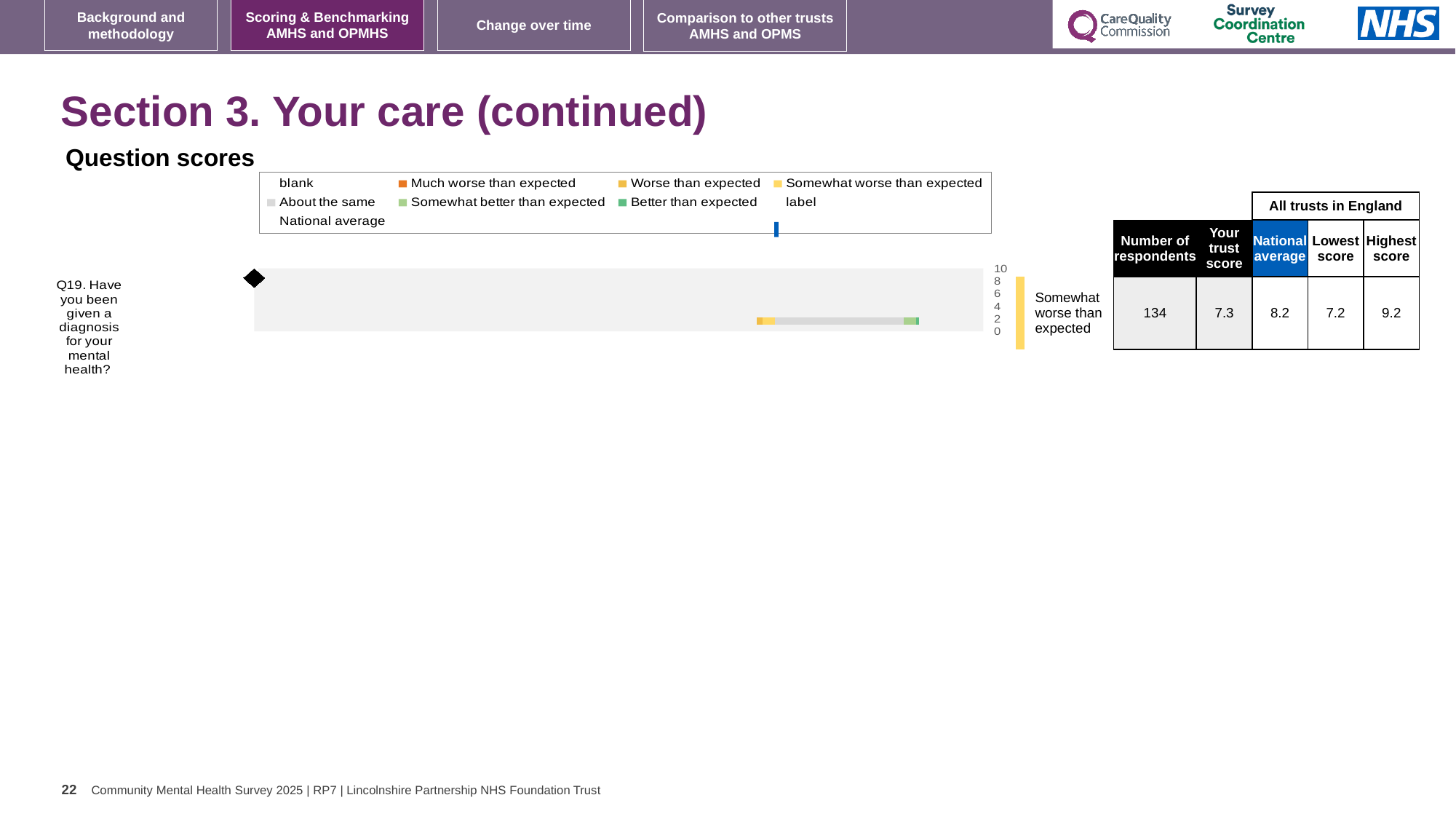
What kind of chart is used to show the question scores on this slide? bar chart What is the difference between the national average and the trust score for Q19? 0.9 Which is larger for Q19, the trust score or the national average? national average Which question is shown in the question scores chart? Q19. Have you been given a diagnosis for your mental health? What is the difference between the highest and lowest scores among all trusts in England for Q19? 2.0 What is the highest score among all trusts in England for Q19? 9.2 What is the national average score for Q19? 8.2 What is the trust score for Q19? 7.3 How many questions are plotted in the question scores chart? 1 How many respondents answered Q19? 134 What benchmark rating label is given to the trust's score for Q19? Somewhat worse than expected What is the lowest score among all trusts in England for Q19? 7.2